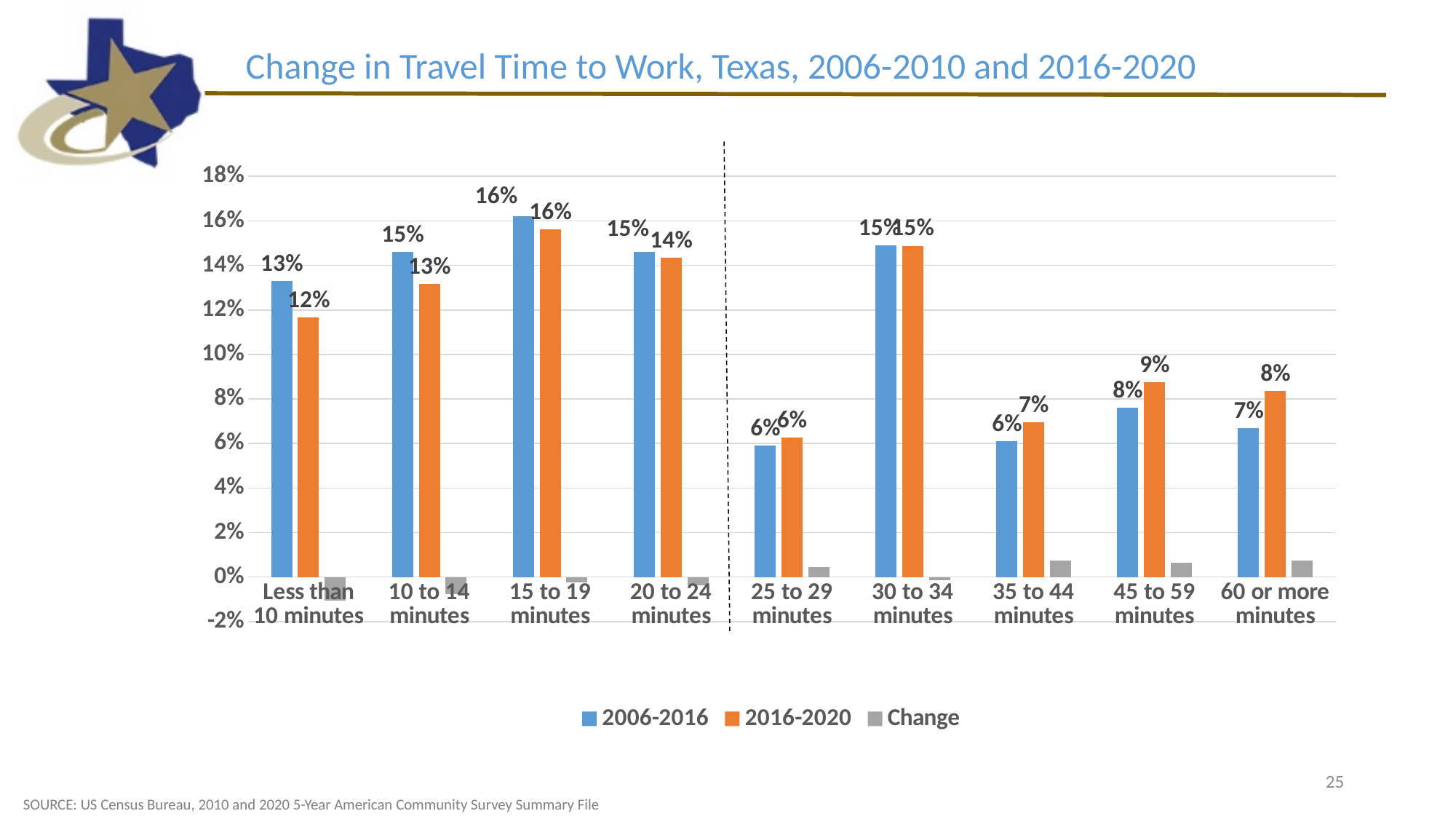
What is the 2006-2016 value for 60 or more minutes? 7% What kind of chart is shown on the slide? bar chart What is the 2016-2020 value for 45 to 59 minutes? 9% How many travel time categories are shown on the x axis? 9 Is the 2006-2016 value for 30 to 34 minutes greater or less than 10%? greater What is the 2006-2016 value for 15 to 19 minutes? 16% Which travel time category has the highest 2016-2020 value? 15 to 19 minutes Which travel time category has the highest 2006-2016 value? 15 to 19 minutes What is the difference between the 2006-2016 and 2016-2020 values for 10 to 14 minutes? 2 percentage points What is the 2016-2020 value for Less than 10 minutes? 12% How many series does the legend list? 3 For 45 to 59 minutes, which is larger: the 2006-2016 value or the 2016-2020 value? 2016-2020